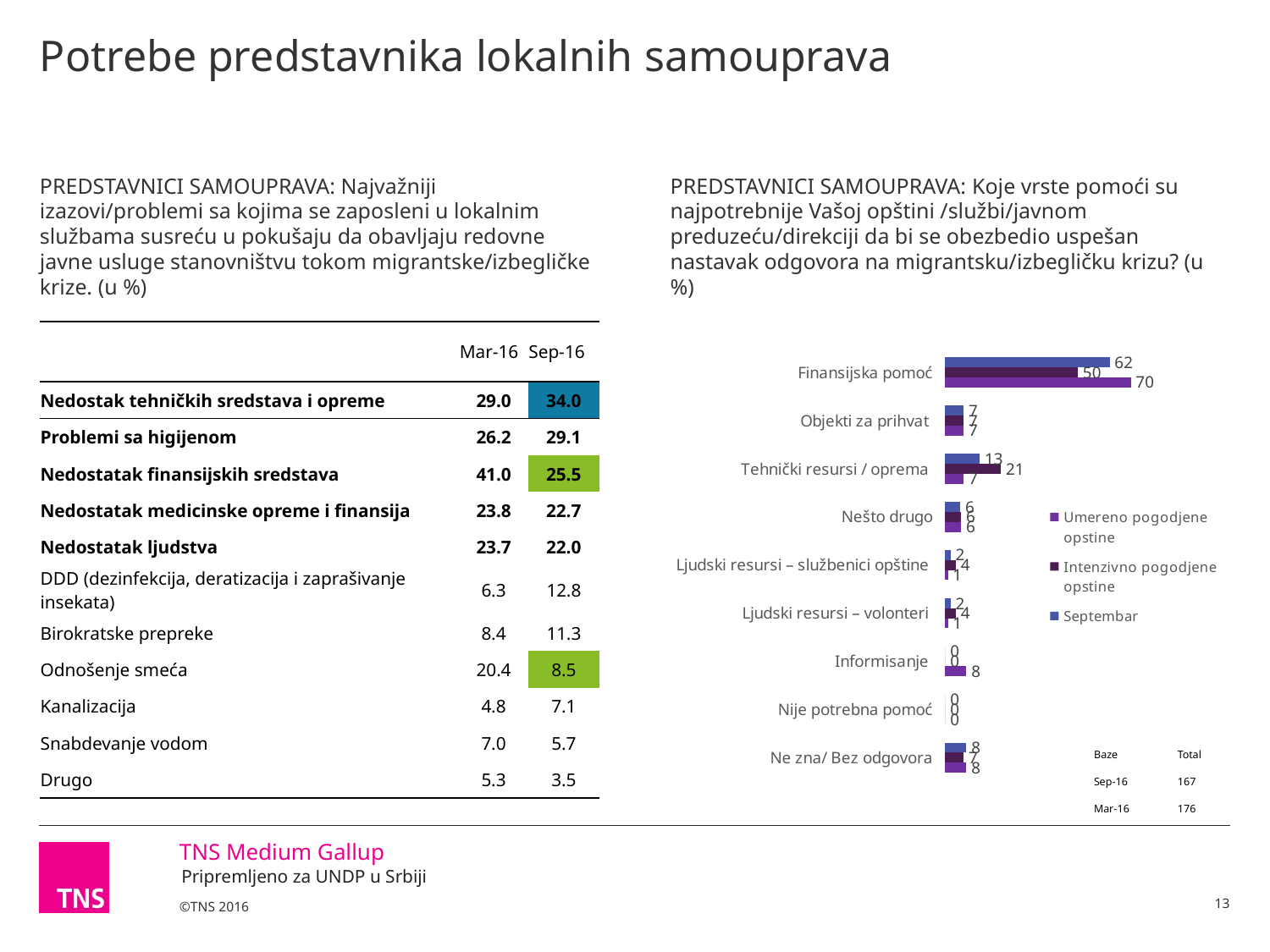
Which category has the highest values in the bar chart? Finansijska pomoć In the bar chart, what is the value of Septembar for Informisanje? 0 What is the third series listed in the legend of the bar chart? Septembar In the bar chart, what is the value of Septembar for Finansijska pomoć? 62 In the bar chart, what is the value of Intenzivno pogodjene opstine for Tehnički resursi / oprema? 21 How many categories are shown on the bar chart? 9 In the bar chart, what is the value of Intenzivno pogodjene opstine for Finansijska pomoć? 50 What kind of chart is shown on the right side of the slide? bar chart In the bar chart, which is larger for Tehnički resursi / oprema: Umereno pogodjene opstine or Intenzivno pogodjene opstine? Intenzivno pogodjene opstine In the bar chart, what is the difference between the Septembar and Intenzivno pogodjene opstine values for Finansijska pomoć? 12 In the bar chart, what is the value of Umereno pogodjene opstine for Nije potrebna pomoć? 0 How many series does the legend of the bar chart list? 3